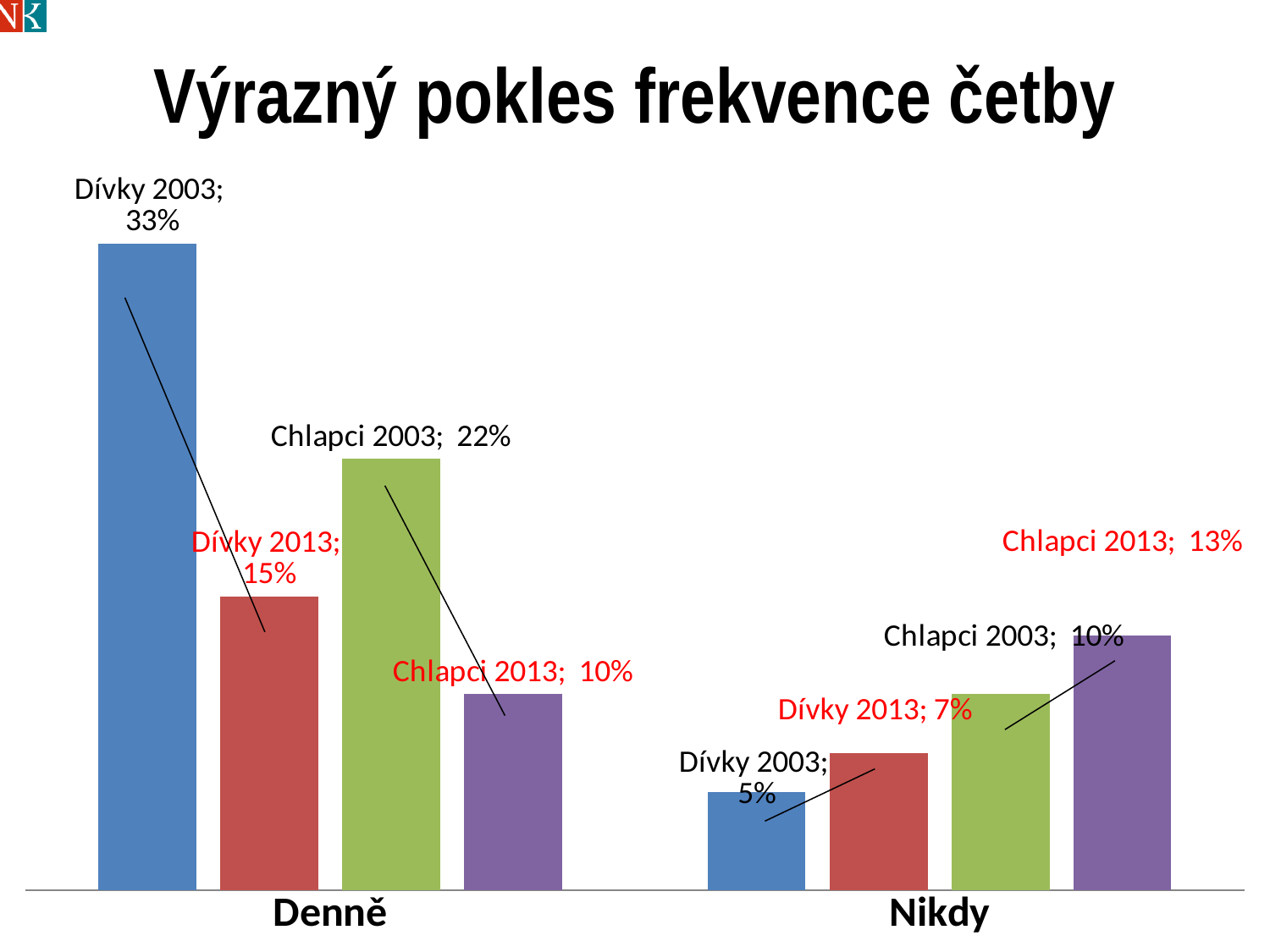
What is the value for Dívky 2003 in the Denně category? 33% Which series has the lowest value in the Nikdy category? Dívky 2003 What is the title of the slide? Výrazný pokles frekvence četby What is the value for Chlapci 2013 in the Nikdy category? 13% What is the value for Chlapci 2003 in the Nikdy category? 10% What is the difference between Dívky 2003 and Dívky 2013 in the Denně category? 18% What is the value for Dívky 2013 in the Denně category? 15% What is the difference between Chlapci 2003 and Chlapci 2013 in the Denně category? 12% What kind of chart is shown on the slide? Bar chart Which series has the highest value in the Denně category? Dívky 2003 Which is larger in the Nikdy category: Dívky 2013 or Chlapci 2013? Chlapci 2013 How many categories are shown on the x axis? 2